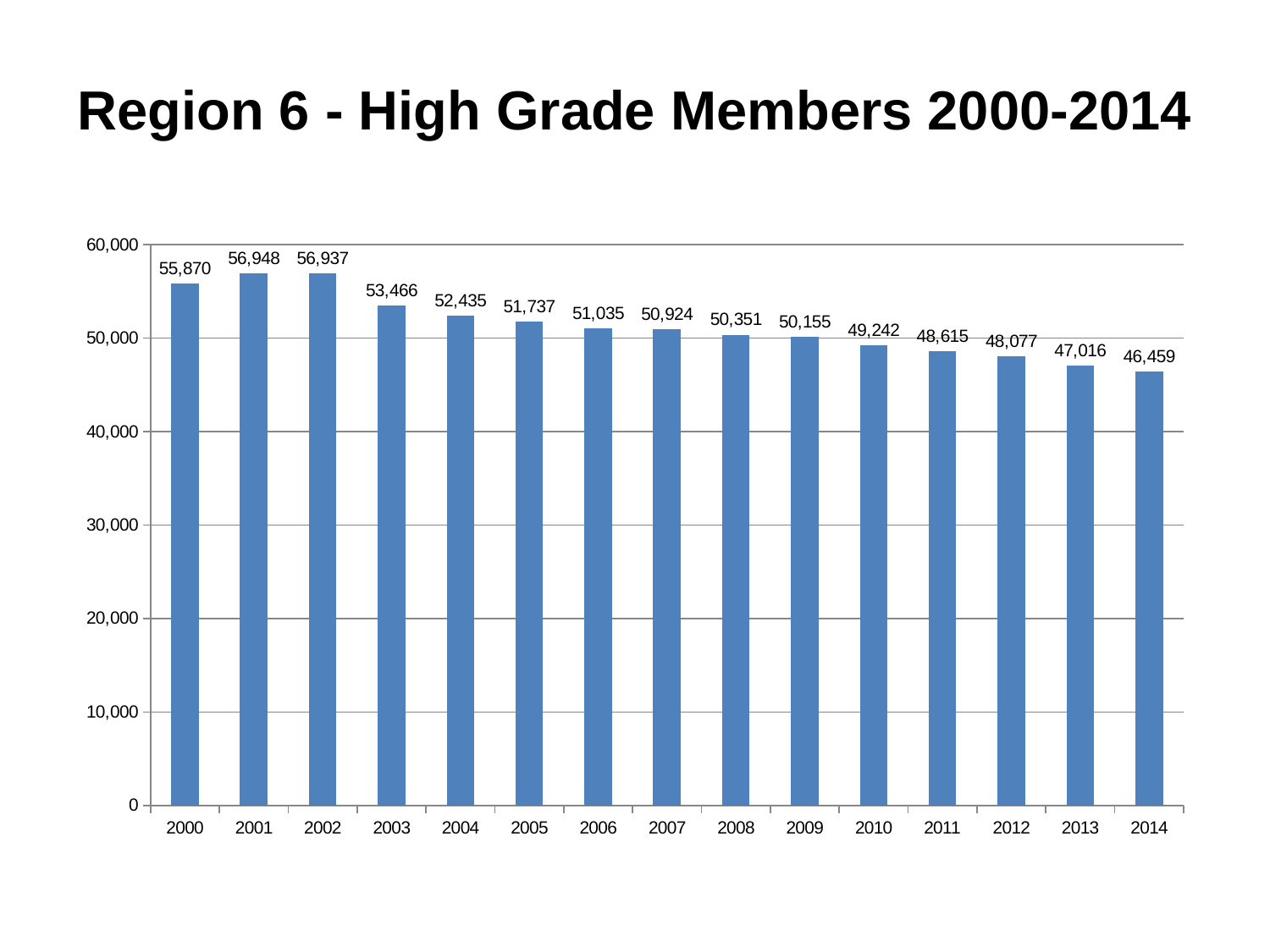
What is the difference between the values for 2000 and 2014? 9,411 How many years are shown on the x axis? 15 Which is larger, the value for 2005 or the value for 2012? 2005 What is the value for 2000? 55,870 What is the value for 2014? 46,459 What kind of chart is this? bar chart What is the difference between the values for 2003 and 2004? 1,031 Which year has the lowest value? 2014 Which year has the highest value? 2001 What is the title of the chart? Region 6 - High Grade Members 2000-2014 What is the value for 2007? 50,924 Is the value for 2010 greater or less than 50,000? less